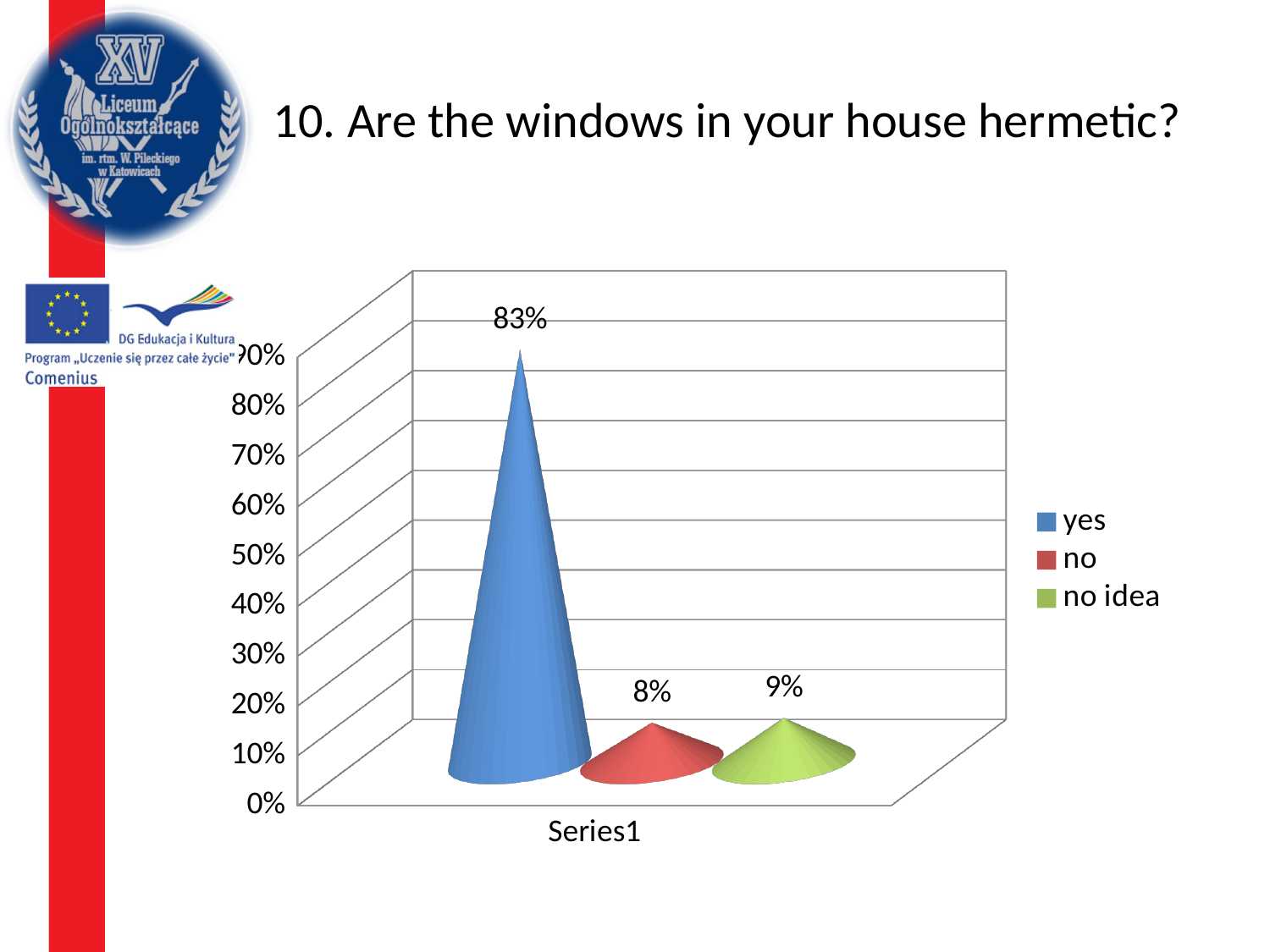
Which is larger, the value for "no" or the value for "no idea"? no idea Is the value for "yes" greater or less than 80%? greater What kind of chart is shown on the slide? bar chart What percentage of respondents answered "yes"? 83% What percentage of respondents answered "no"? 8% Which answer has the highest percentage? yes What percentage of respondents answered "no idea"? 9% How many series does the legend list? 3 What is the difference in percentage points between "no idea" and "no"? 1 What is the difference in percentage points between "yes" and "no idea"? 74 Which answer has the lowest percentage? no What is the title of the slide above the chart? 10. Are the windows in your house hermetic?